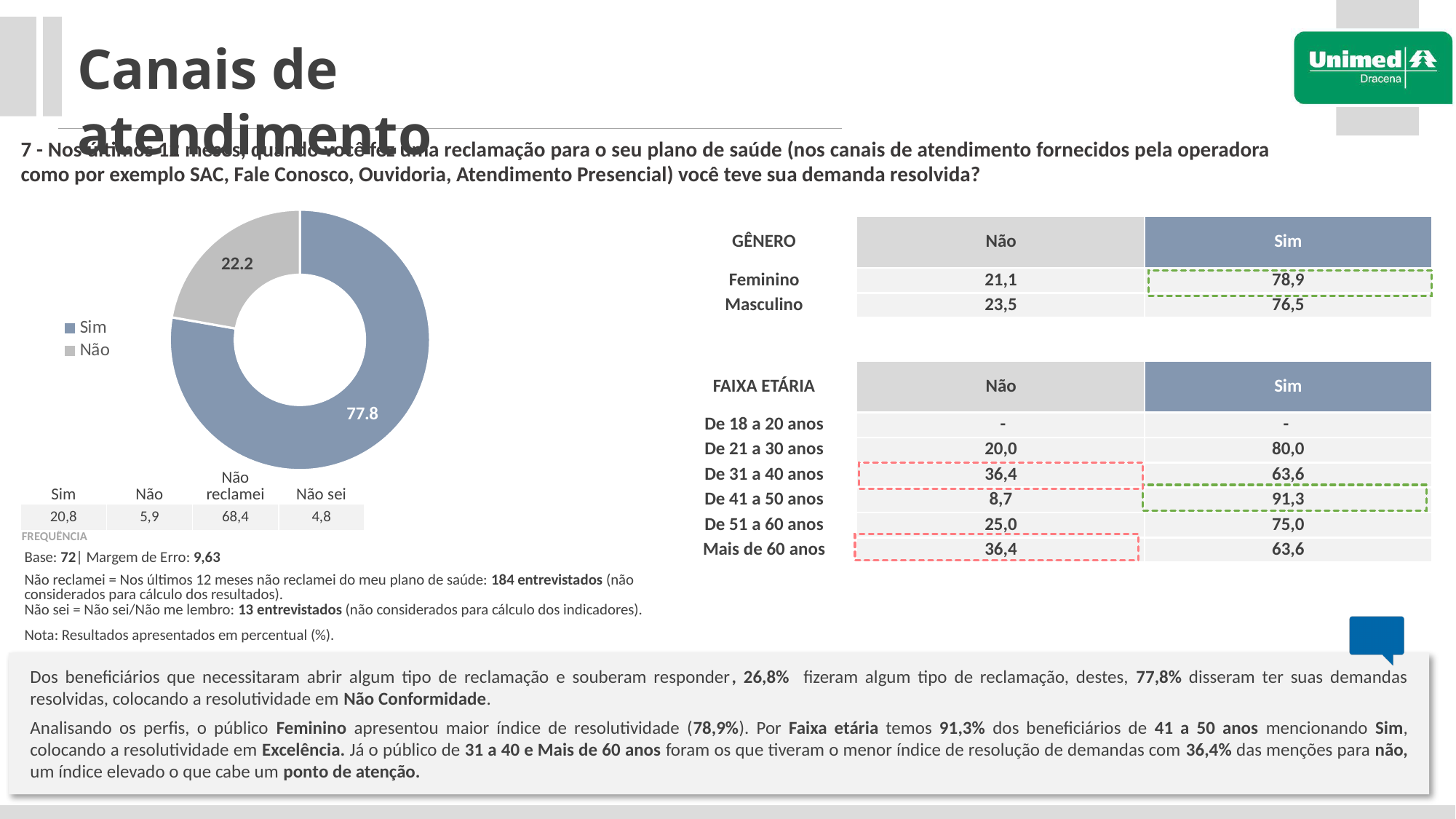
How many slices does the donut chart have? 2 What is the value shown for Sim in the donut chart? 77.8 What colour is the Não slice in the donut chart? Grey What are the two legend entries of the donut chart? Sim and Não Which slice of the donut chart is the smallest? Não What is the value shown for Não in the donut chart? 22.2 What share of the donut chart does the Sim slice represent? 77.8 In the donut chart, which is larger, Sim or Não? Sim What is the difference between the Sim and Não values in the donut chart? 55.6 How many entries does the legend of the donut chart list? 2 What type of chart is shown on the left of the slide? Pie chart (donut) Which slice of the donut chart is the largest? Sim